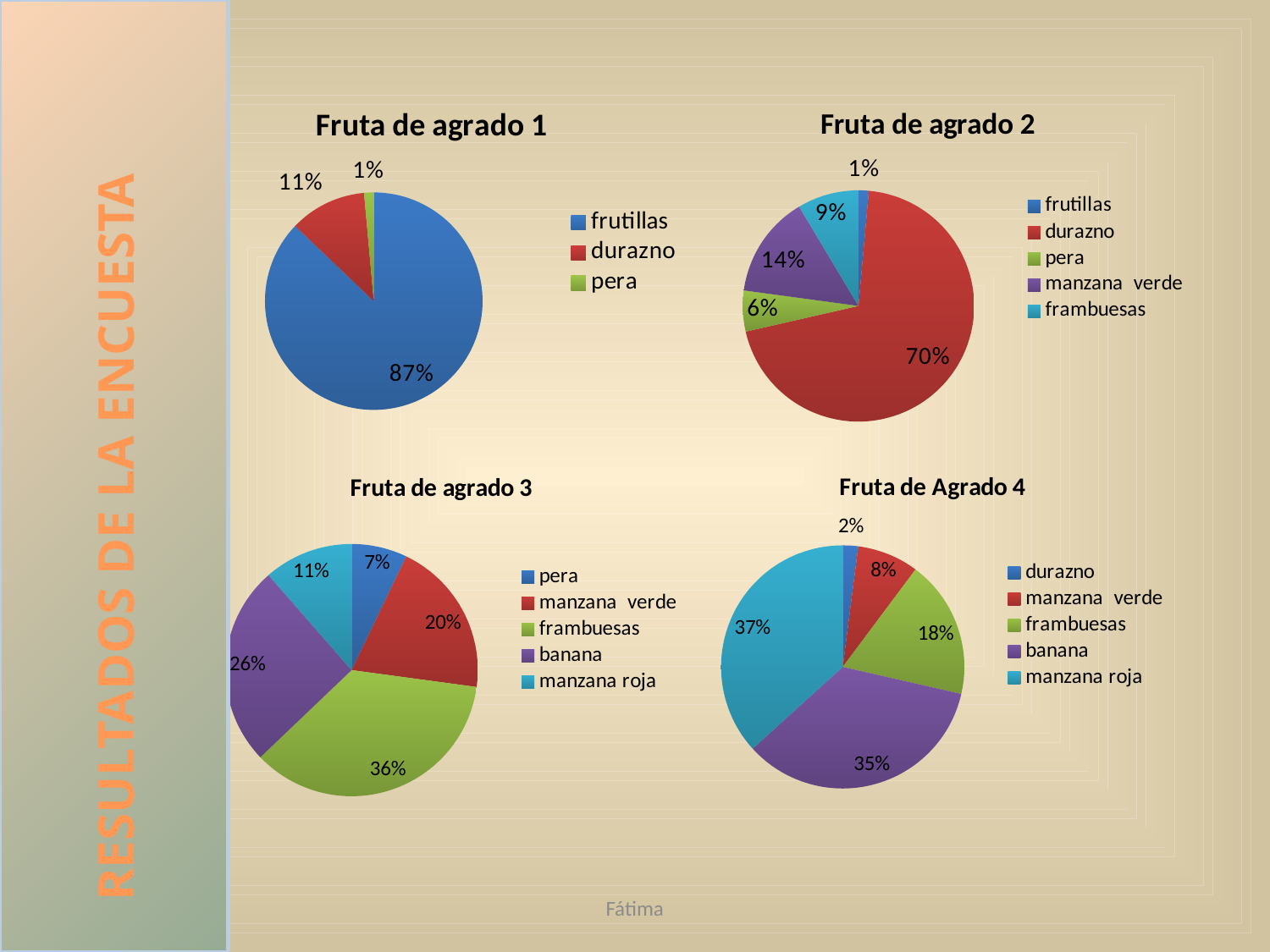
In the 'Fruta de agrado 3' chart, which is larger, manzana verde or manzana roja? manzana verde In the 'Fruta de agrado 3' chart, which fruit has the largest slice? frambuesas In the 'Fruta de Agrado 4' chart, what percentage is shown for manzana roja? 37% In the 'Fruta de agrado 1' chart, which fruit has the smallest slice? pera In the 'Fruta de agrado 1' chart, what share does frutillas have? 87% In the 'Fruta de agrado 3' chart, what share does banana have? 26% How many charts are shown on the slide? 4 In the 'Fruta de agrado 2' chart, what is the difference between the manzana verde and frambuesas shares? 5% In the 'Fruta de Agrado 4' chart, which fruit has the smallest slice? durazno In the 'Fruta de agrado 2' chart, what percentage is shown for durazno? 70% How many categories does the legend of the 'Fruta de agrado 2' chart list? 5 What type of chart is 'Fruta de agrado 1'? pie chart